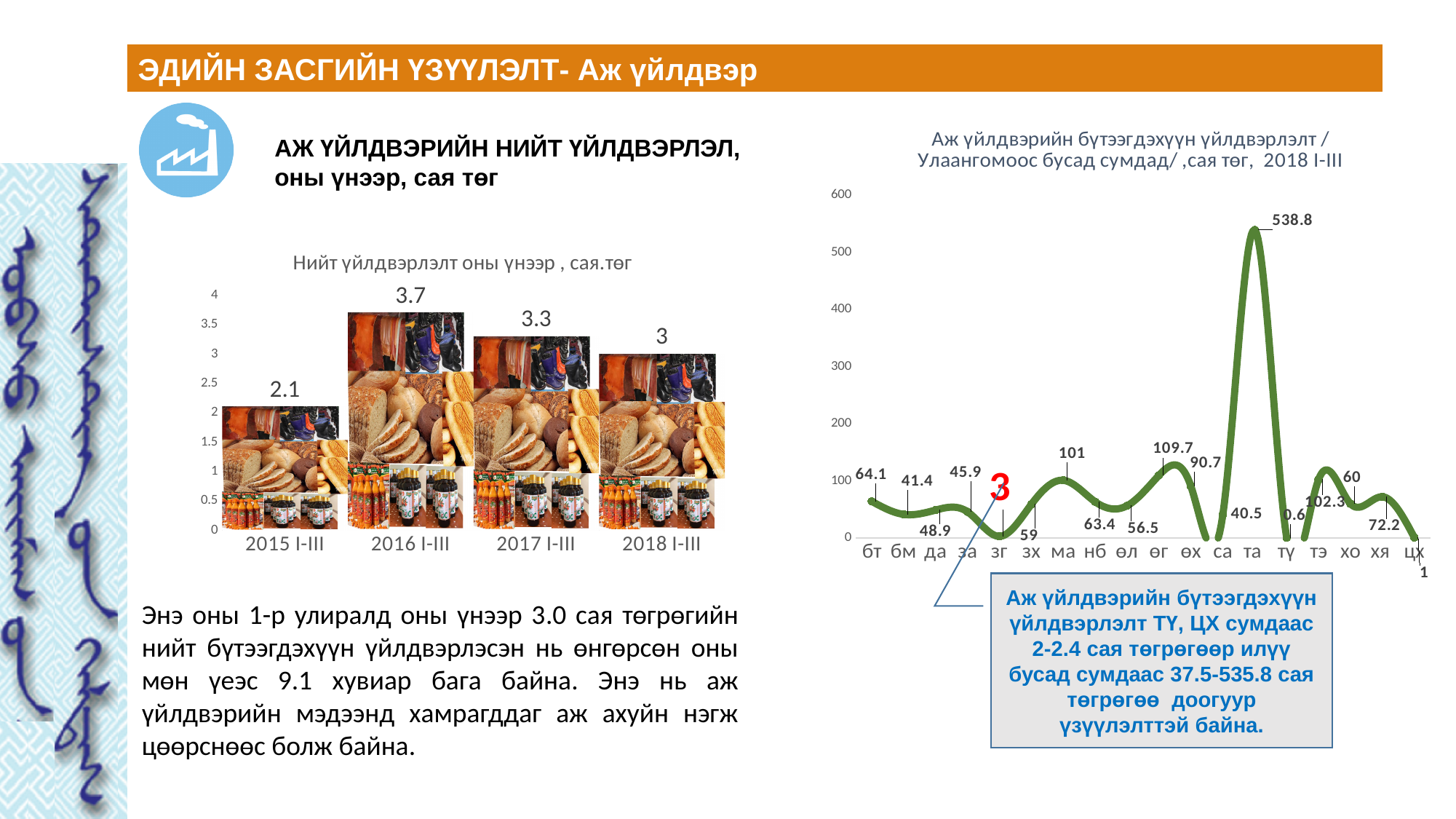
On the right chart 'Аж үйлдвэрийн бүтээгдэхүүн үйлдвэрлэлт', is the value for та greater or less than 500? greater On the right chart 'Аж үйлдвэрийн бүтээгдэхүүн үйлдвэрлэлт', what is the value for ма? 101 On the left chart 'Нийт үйлдвэрлэлт оны үнээр , сая.төг', what is the value for 2016 I-III? 3.7 On the left chart 'Нийт үйлдвэрлэлт оны үнээр , сая.төг', which period has the lowest value? 2015 I-III On the left chart 'Нийт үйлдвэрлэлт оны үнээр , сая.төг', which period has the highest value? 2016 I-III On the left chart 'Нийт үйлдвэрлэлт оны үнээр , сая.төг', what is the difference between the 2016 I-III and 2017 I-III values? 0.4 On the right chart 'Аж үйлдвэрийн бүтээгдэхүүн үйлдвэрлэлт', which is larger, the value for бт or for бм? бт On the right chart 'Аж үйлдвэрийн бүтээгдэхүүн үйлдвэрлэлт', which category has the highest value? та On the right chart 'Аж үйлдвэрийн бүтээгдэхүүн үйлдвэрлэлт', what is the value for та? 538.8 What kind of chart is the right chart 'Аж үйлдвэрийн бүтээгдэхүүн үйлдвэрлэлт'? Line chart On the left chart 'Нийт үйлдвэрлэлт оны үнээр , сая.төг', how many periods are shown? 4 What kind of chart is the left chart 'Нийт үйлдвэрлэлт оны үнээр , сая.төг'? Bar chart